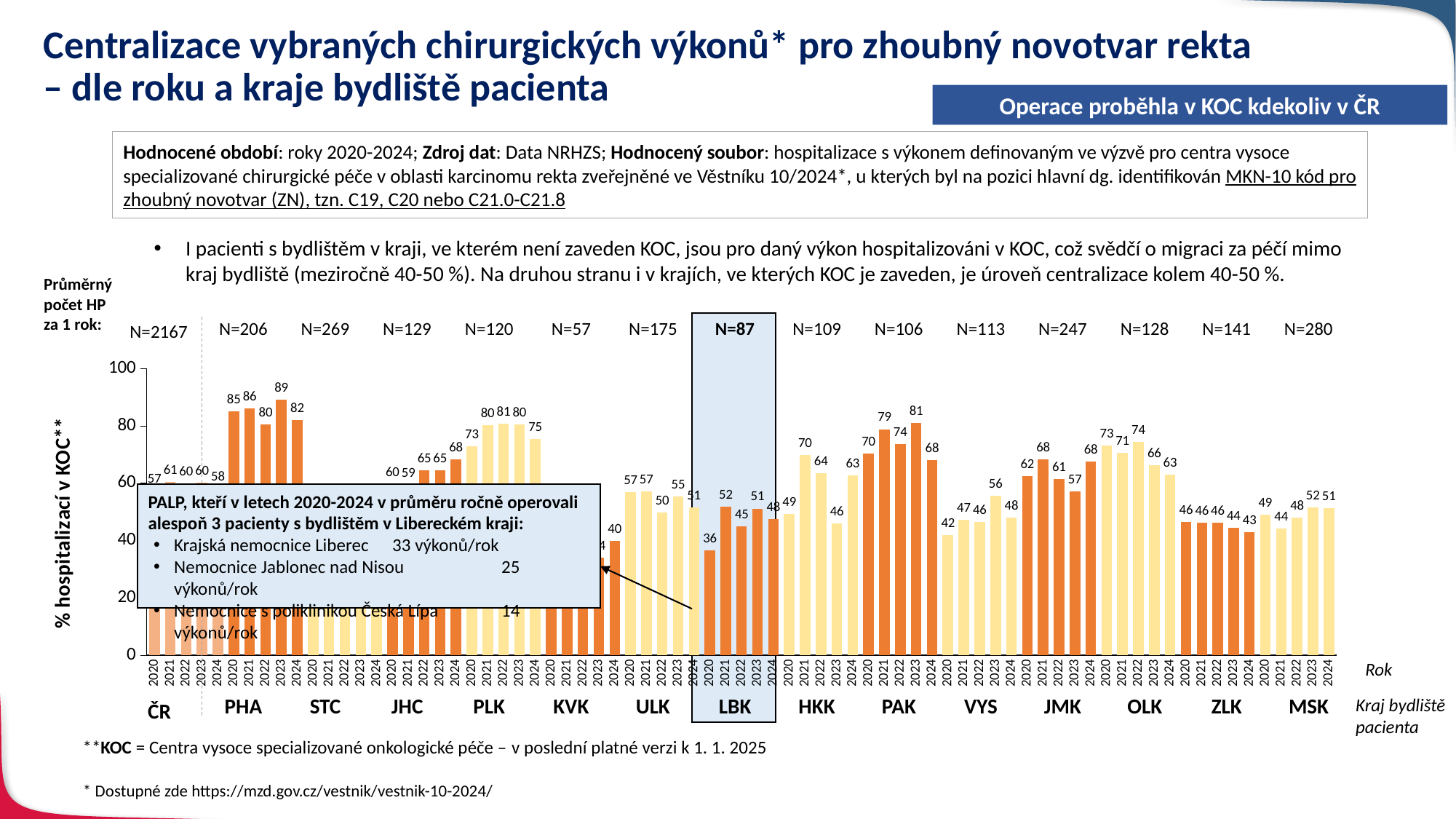
What is the difference between the PAK values for 2023 and 2024? 13 What is the value for LBK in 2020? 36 What is the value for ČR in 2021? 61 What is the value for PHA in 2023? 89 What is the average annual number of hospitalizations (N) shown above the LBK group? N=87 Do the values for ZLK rise or fall from 2020 to 2024? fall Is the value for PHA in 2020 greater or less than 80? greater What kind of chart is shown on the slide? bar chart How many years (bars) are shown for each region? 5 Which year has the lowest value within the LBK group? 2020 Which is larger, the 2020 value for OLK or the 2020 value for MSK? OLK Which year has the highest value within the PHA group? 2023